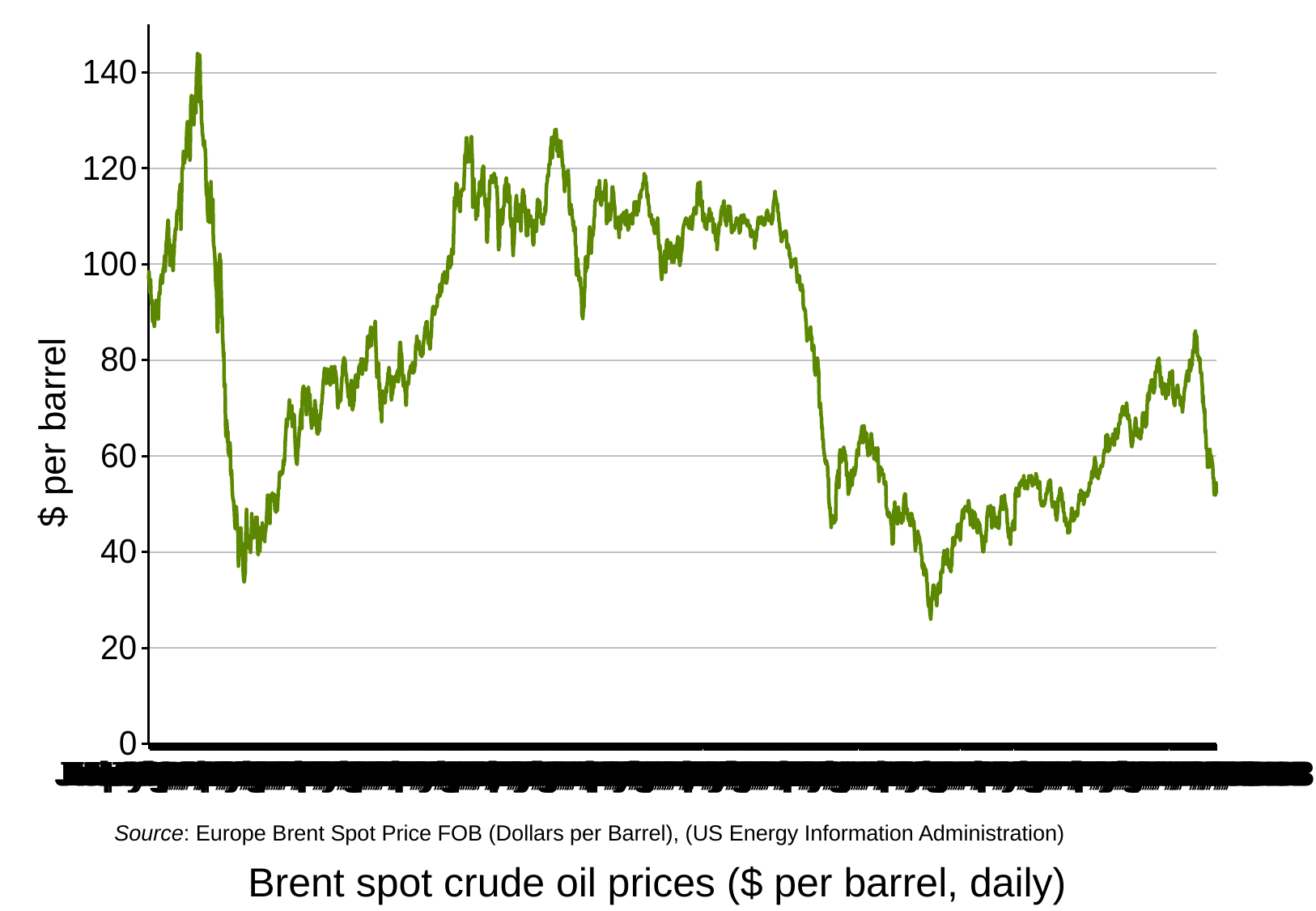
Is the highest value reached by the line greater or less than 120? greater What kind of chart is shown on the slide? line chart Is the value at the right-hand end of the line greater or less than 80? less Comparing the start of the line to its end, does the price rise or fall overall across the chart? fall Is the lowest value reached by the line greater or less than 40? less What is the title of the chart? Brent spot crude oil prices ($ per barrel, daily) What is the label on the vertical axis of the chart? $ per barrel Which is larger: the peak near the left of the chart or the peak near the right of the chart? the peak near the left How many data series are plotted on the chart? 1 What is the highest value shown on the vertical axis? 140